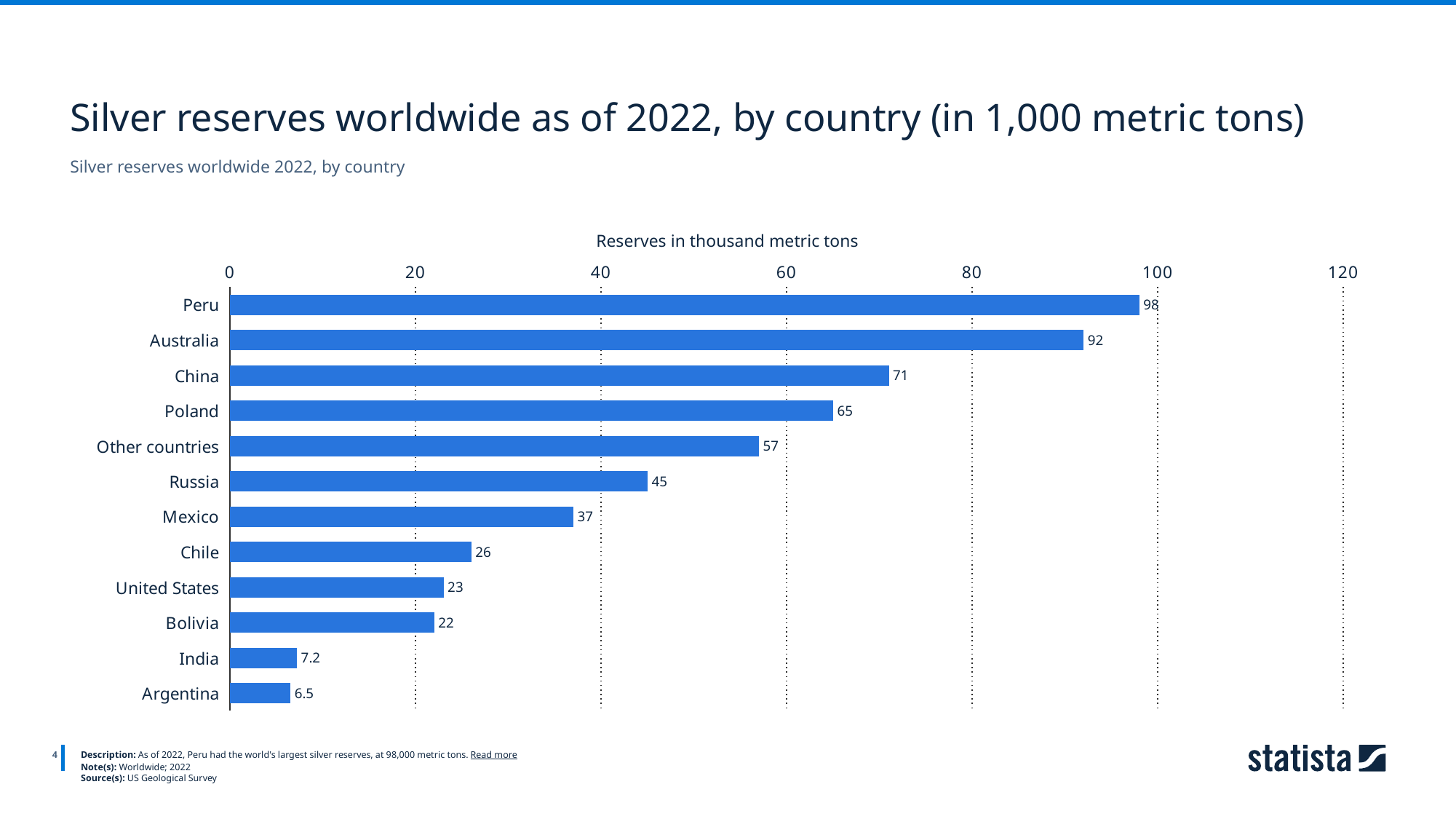
Which is larger, the value for Poland or the value for Other countries? Poland How many categories are shown in the chart? 12 Which country has the highest silver reserves? Peru What is the title of the x axis? Reserves in thousand metric tons What is the value for Peru? 98 What is the difference between the values for China and Mexico? 34 What kind of chart is shown on the slide? bar chart Which category has the lowest value? Argentina What is the value for Russia? 45 What is the difference between the values for Peru and Australia? 6 What is the value for India? 7.2 Is the value for Chile greater or less than 20? greater